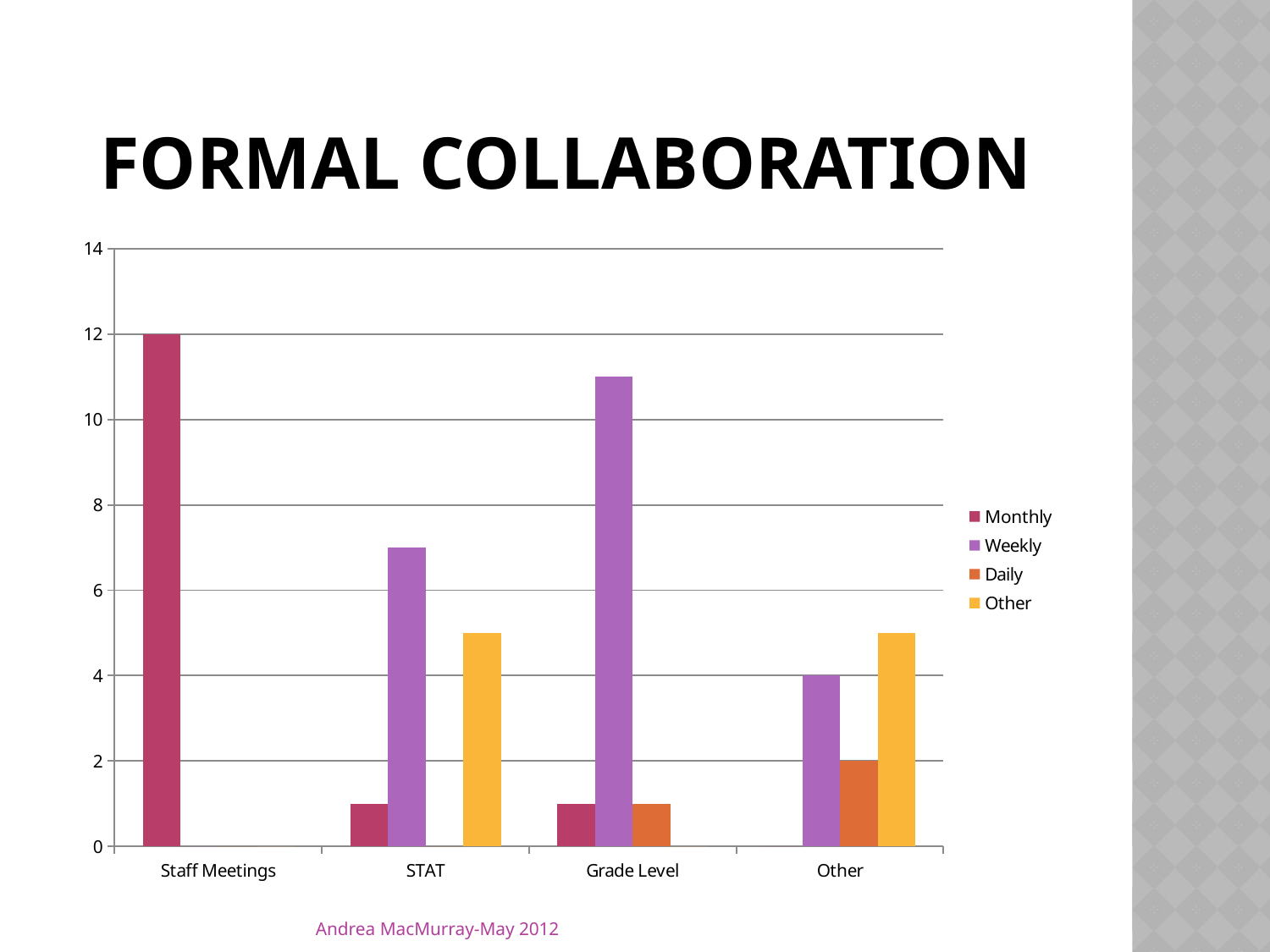
What is the Monthly value for Staff Meetings? 12 How many series does the legend list? 4 What is the title of the chart? Formal Collaboration Which is larger, the Weekly value for STAT or the Weekly value for Grade Level? Grade Level What is the difference between the Monthly value for Staff Meetings and the Weekly value for Other? 8 Is the Weekly value for Grade Level greater or less than 10? greater What is the Weekly value for Other? 4 Is the Weekly value for STAT greater or less than 6? greater What is the Daily value for Other? 2 What type of chart is shown on the slide? bar chart Which category has the tallest bar in the chart? Staff Meetings How many categories are shown on the x axis? 4